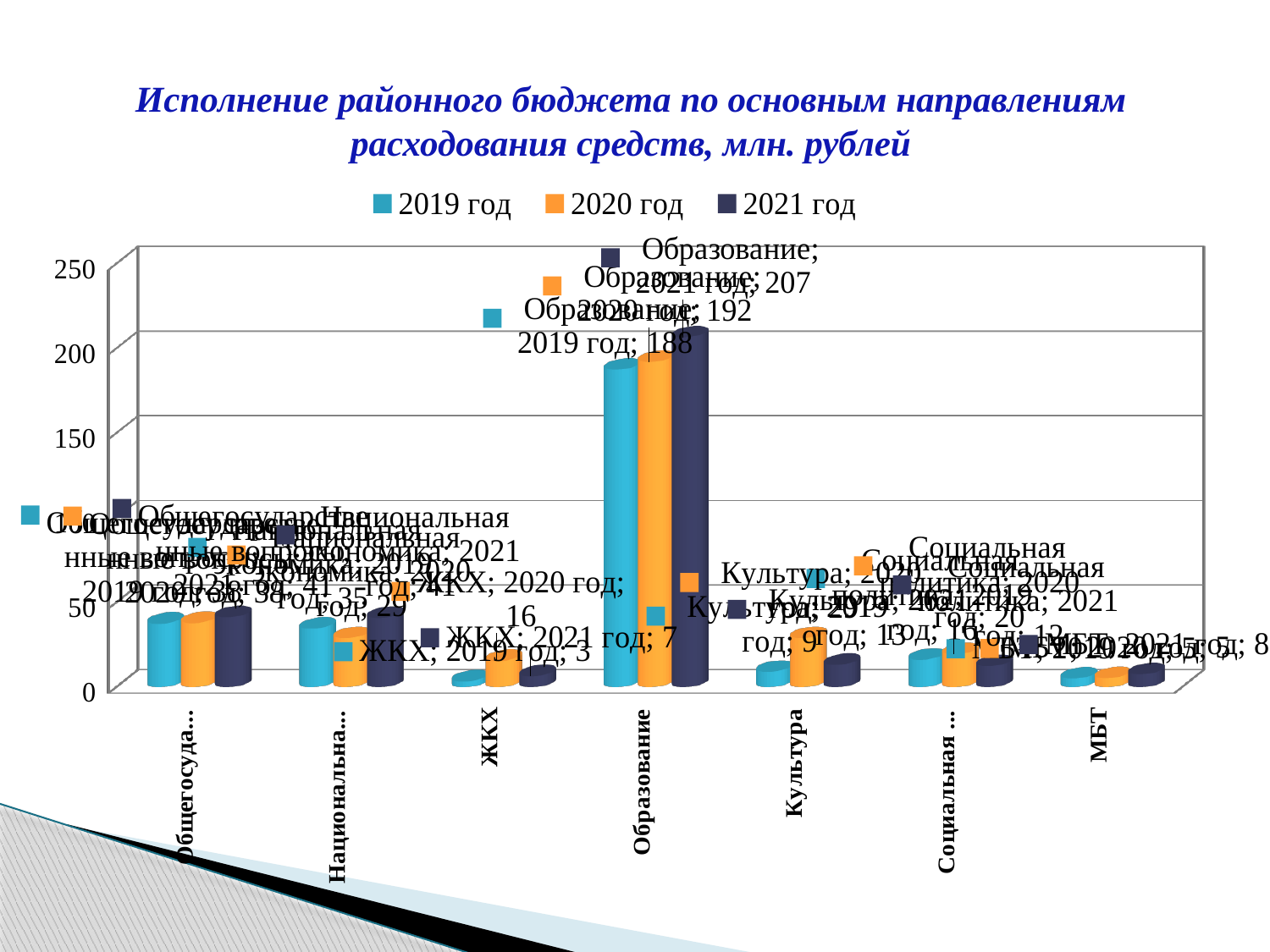
What is the value for Образование in 2021 год? 207 Do the values for Образование rise or fall from 2019 год to 2021 год? rise What is the value for ЖКХ in 2019 год? 3 What is the value for ЖКХ in 2020 год? 16 How many categories are shown along the x axis? 7 Which category has the highest values across all three years? Образование What kind of chart is shown on the slide? bar chart For ЖКХ, which year has the larger value, 2020 год or 2021 год? 2020 год What is the value for Образование in 2020 год? 192 What is the value for Образование in 2019 год? 188 How many series does the legend list? 3 What is the difference between the Образование values for 2021 год and 2019 год? 19